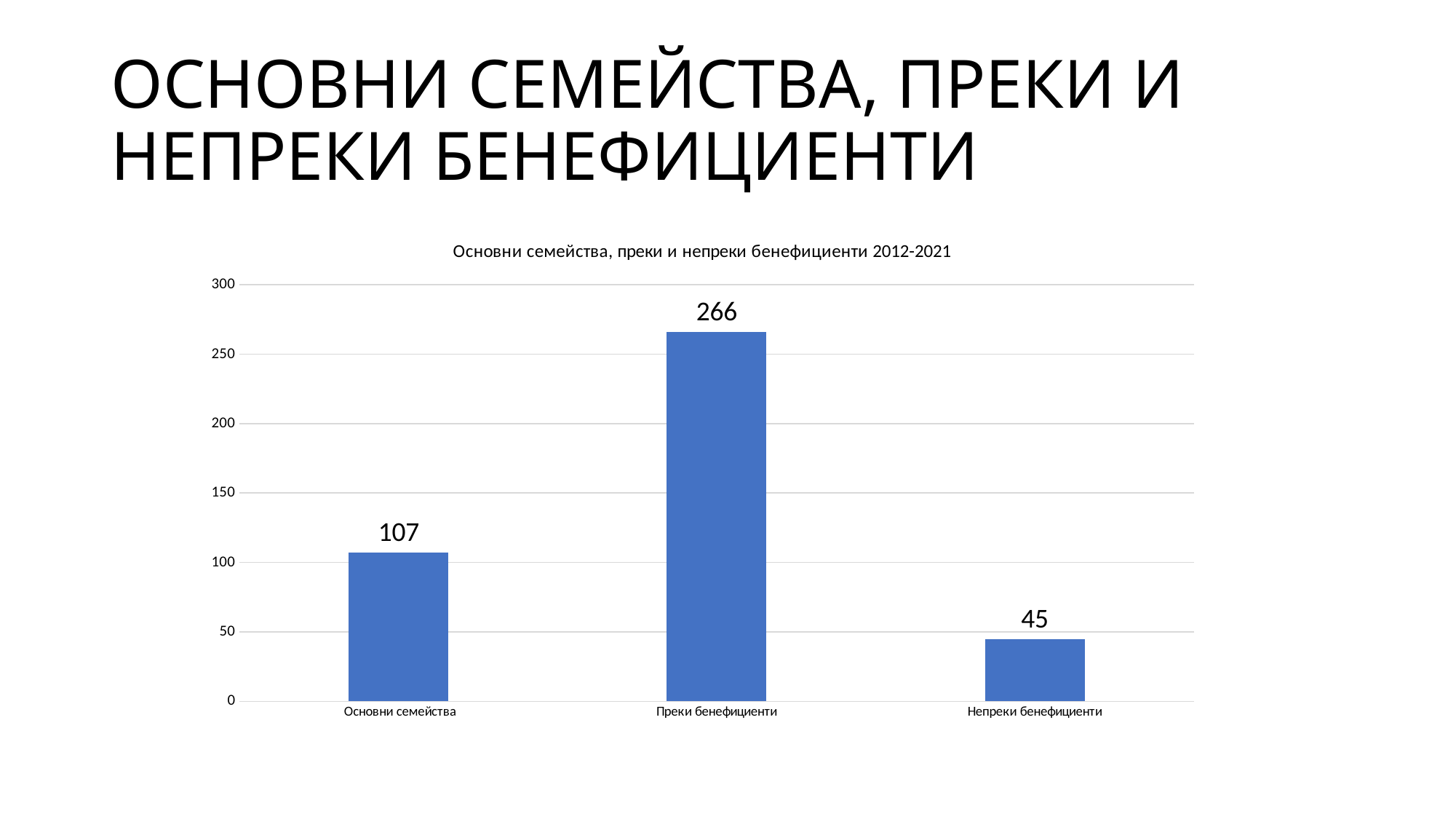
What is the difference between the values for Основни семейства and Непреки бенефициенти? 62 What is the value for Основни семейства? 107 What is the value for Непреки бенефициенти? 45 What kind of chart is shown on the slide? bar chart Which is larger, the value for Основни семейства or the value for Непреки бенефициенти? Основни семейства Which category has the highest value? Преки бенефициенти Is the value for Преки бенефициенти greater or less than 250? greater How many categories are shown in the chart? 3 What is the value for Преки бенефициенти? 266 Which category has the lowest value? Непреки бенефициенти What is the title of the chart? Основни семейства, преки и непреки бенефициенти 2012-2021 What is the difference between the values for Преки бенефициенти and Основни семейства? 159